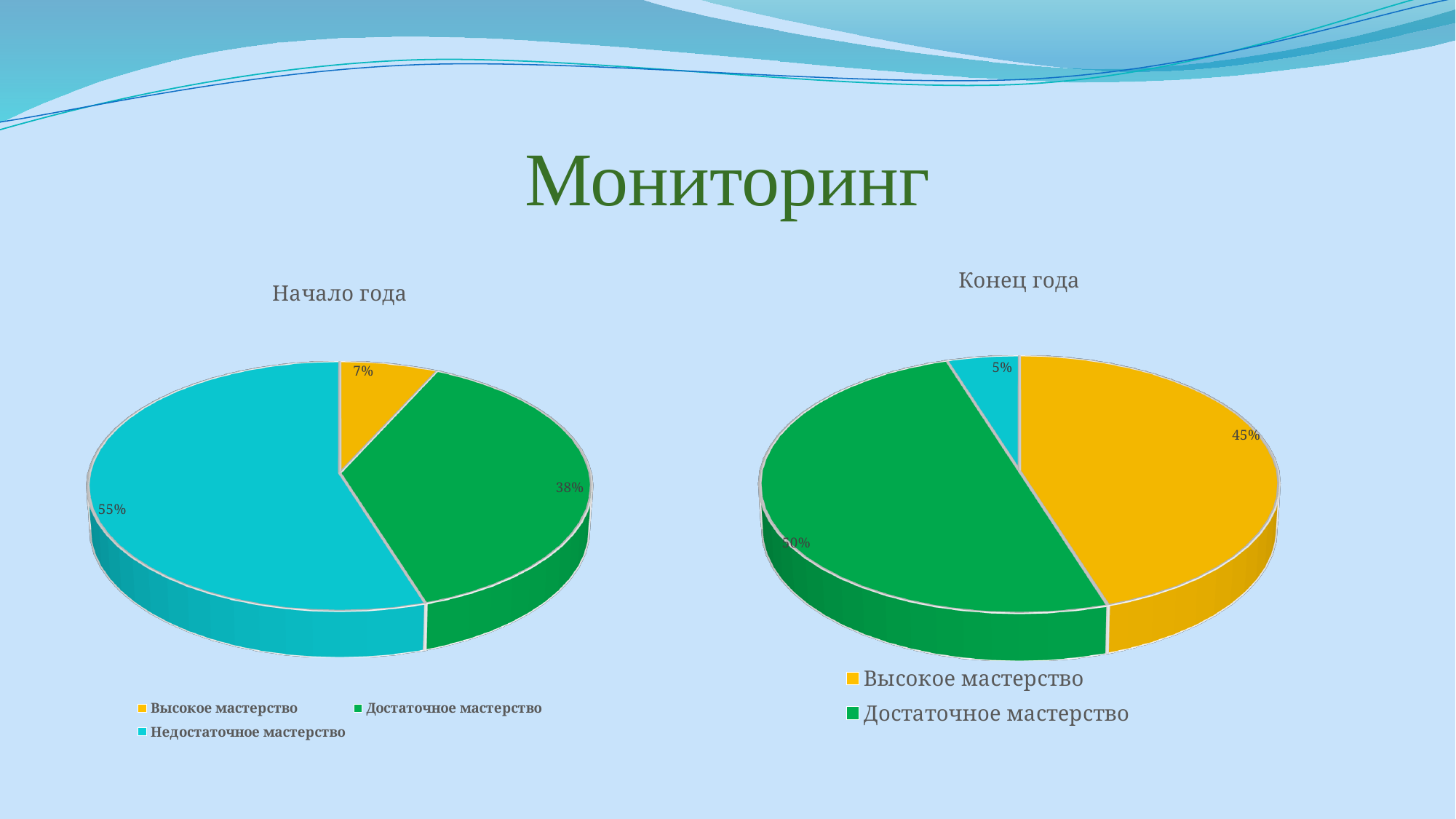
In the "Начало года" chart, which category has the largest slice? Недостаточное мастерство How many entries does the legend of the "Конец года" chart list? 2 Which is larger in the "Начало года" chart: Достаточное мастерство or Высокое мастерство? Достаточное мастерство What type of chart is used for "Конец года"? Pie chart In the "Начало года" chart, what is the difference between the Недостаточное мастерство and Достаточное мастерство slices? 17% In the "Конец года" chart, what percentage is shown for Высокое мастерство? 45% In the "Начало года" chart, which category has the smallest slice? Высокое мастерство In the "Конец года" chart, which category has the largest slice? Достаточное мастерство In the "Начало года" chart, what percentage is shown for Высокое мастерство? 7% How many slices does the "Начало года" chart have? 3 In the "Конец года" chart, what percentage is shown for Достаточное мастерство? 50% In the "Начало года" chart, what percentage is shown for Недостаточное мастерство? 55%